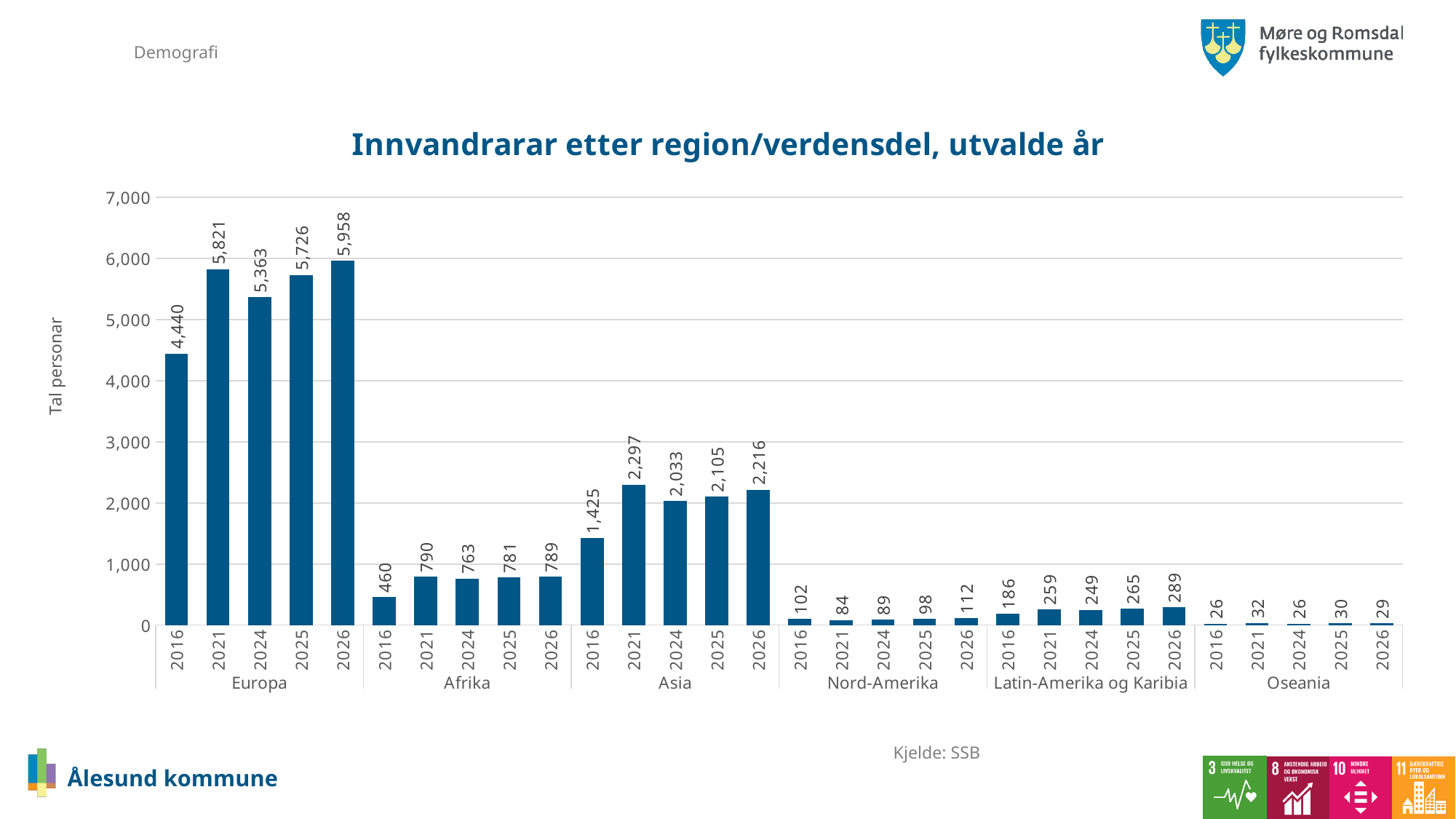
What is the value for Asia in 2016? 1,425 What is the difference between the Europa values for 2026 and 2016? 1,518 Which region and year has the highest value on the chart? Europa 2026 Which is larger: Asia in 2021 or Asia in 2026? Asia in 2021 Is the value for Europa in 2024 greater or less than 5,000? greater What kind of chart is shown on the slide? bar chart What is the value for Europa in 2026? 5,958 What is the value for Oseania in 2025? 30 What is the title of the chart? Innvandrarar etter region/verdensdel, utvalde år Which year has the lowest value for Nord-Amerika? 2021 What is the value for Afrika in 2021? 790 How many regions are shown on the x axis? 6